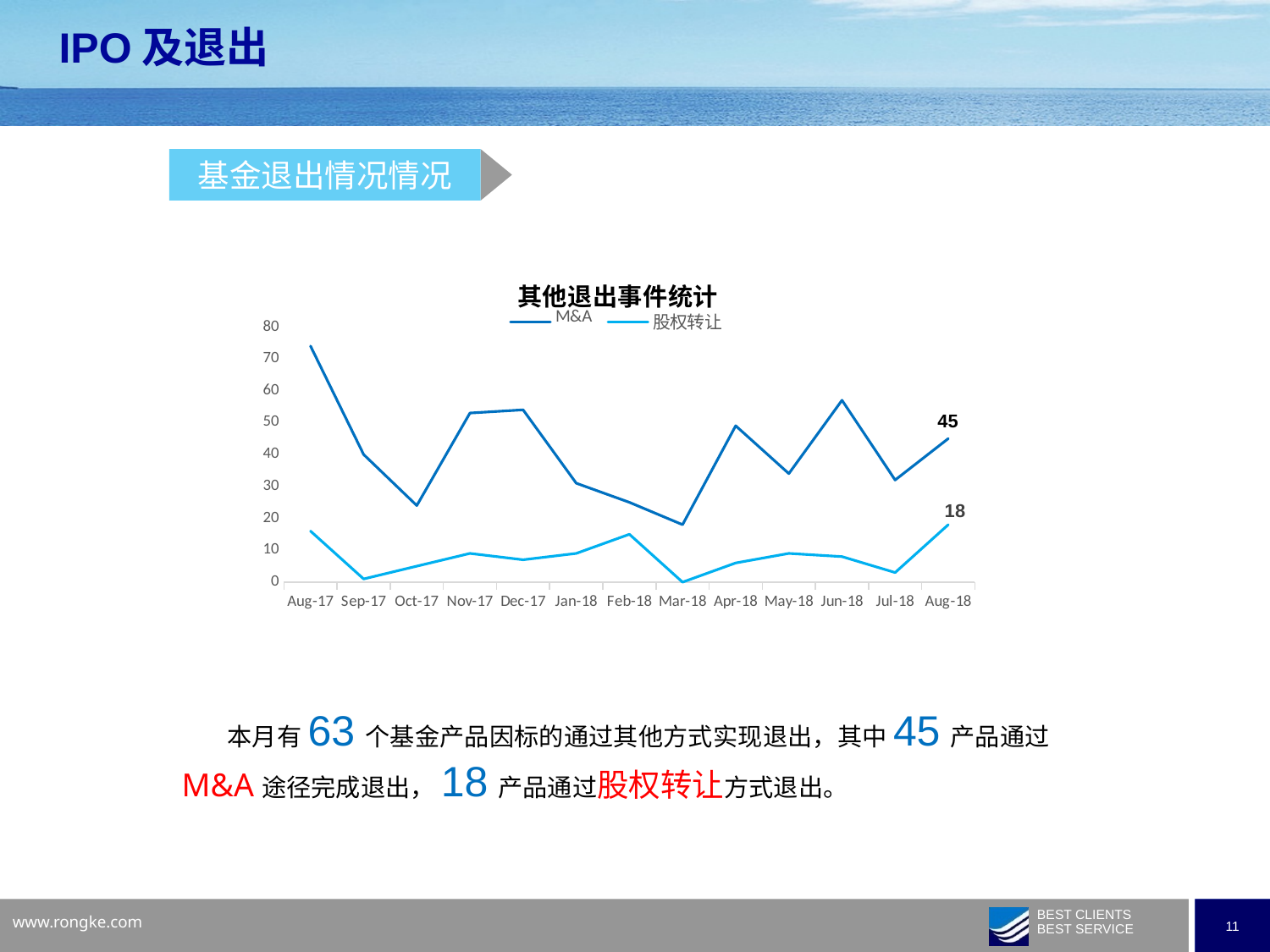
Does the M&A series rise or fall from Aug-17 to Oct-17? Fall How many series does the legend of the 其他退出事件统计 chart list? 2 What is the 股权转让 value for Aug-18? 18 In Aug-18, which series has the larger value, M&A or 股权转让? M&A What type of chart is shown under the title 其他退出事件统计? Line chart How many months are shown on the x axis of the chart? 13 What is the M&A value for Aug-18? 45 In which month is the M&A series at its highest? Aug-17 Is the M&A value for Oct-17 greater or less than 30? less What are the two series named in the legend of the chart? M&A and 股权转让 What is the difference between the M&A value and the 股权转让 value in Aug-18? 27 Is the M&A value for Aug-17 greater or less than 70? greater